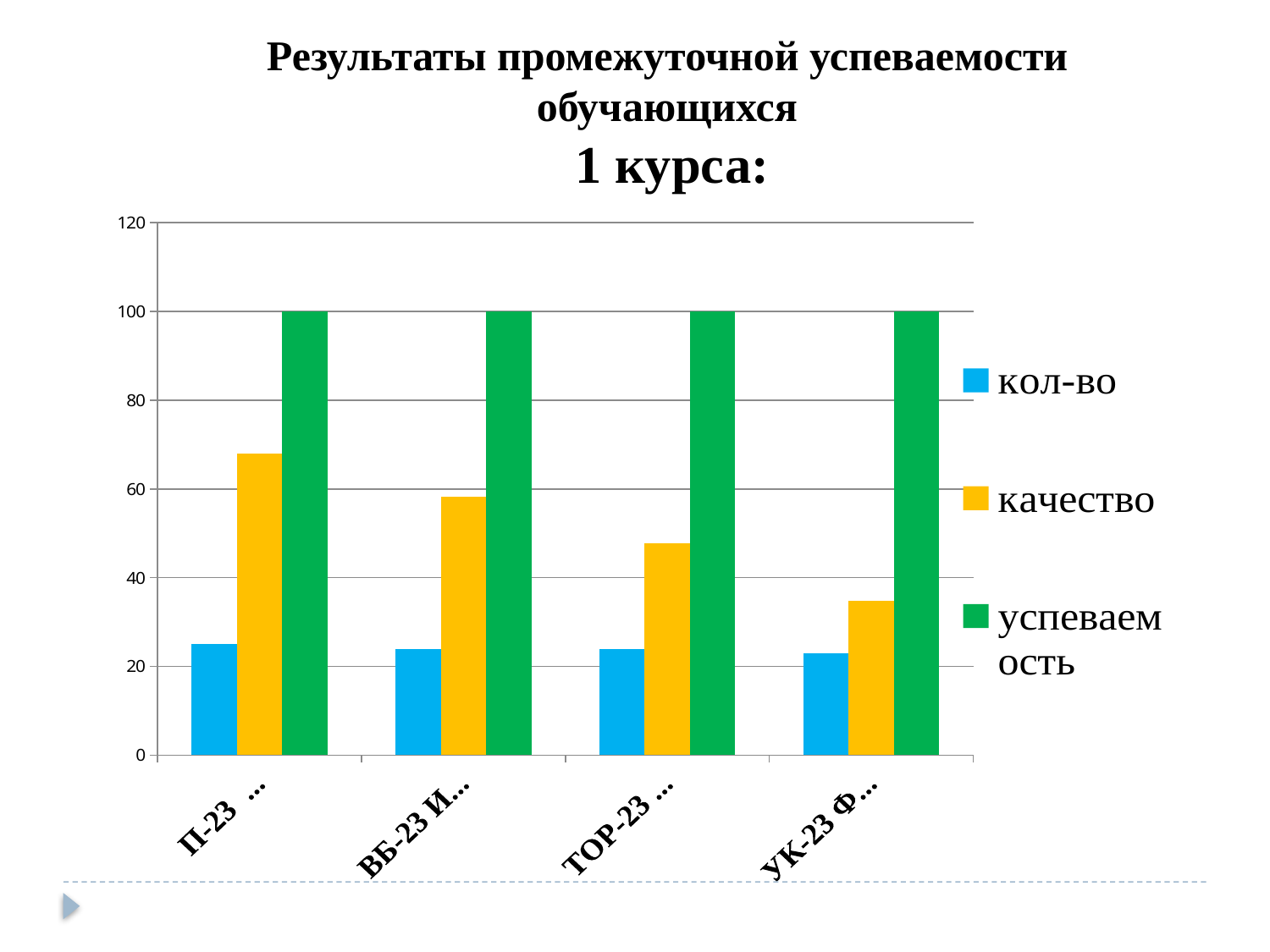
What kind of chart is shown on the slide? bar chart Is the value of кол-во for ТОР-23 greater or less than 40? less How many groups (categories) are shown on the x axis? 4 What is the value of успеваемость for the group П-23? 100 Is the value of качество for П-23 greater or less than 60? greater Which group has the larger качество value, П-23 or ВБ-23? П-23 What is the value of успеваемость for the group УК-23? 100 Which group has the highest value for качество? П-23 Do the качество values rise or fall from left to right across the groups? fall Which group has the lowest value for качество? УК-23 How many series does the legend list? 3 Is the value of качество for УК-23 greater or less than 40? less